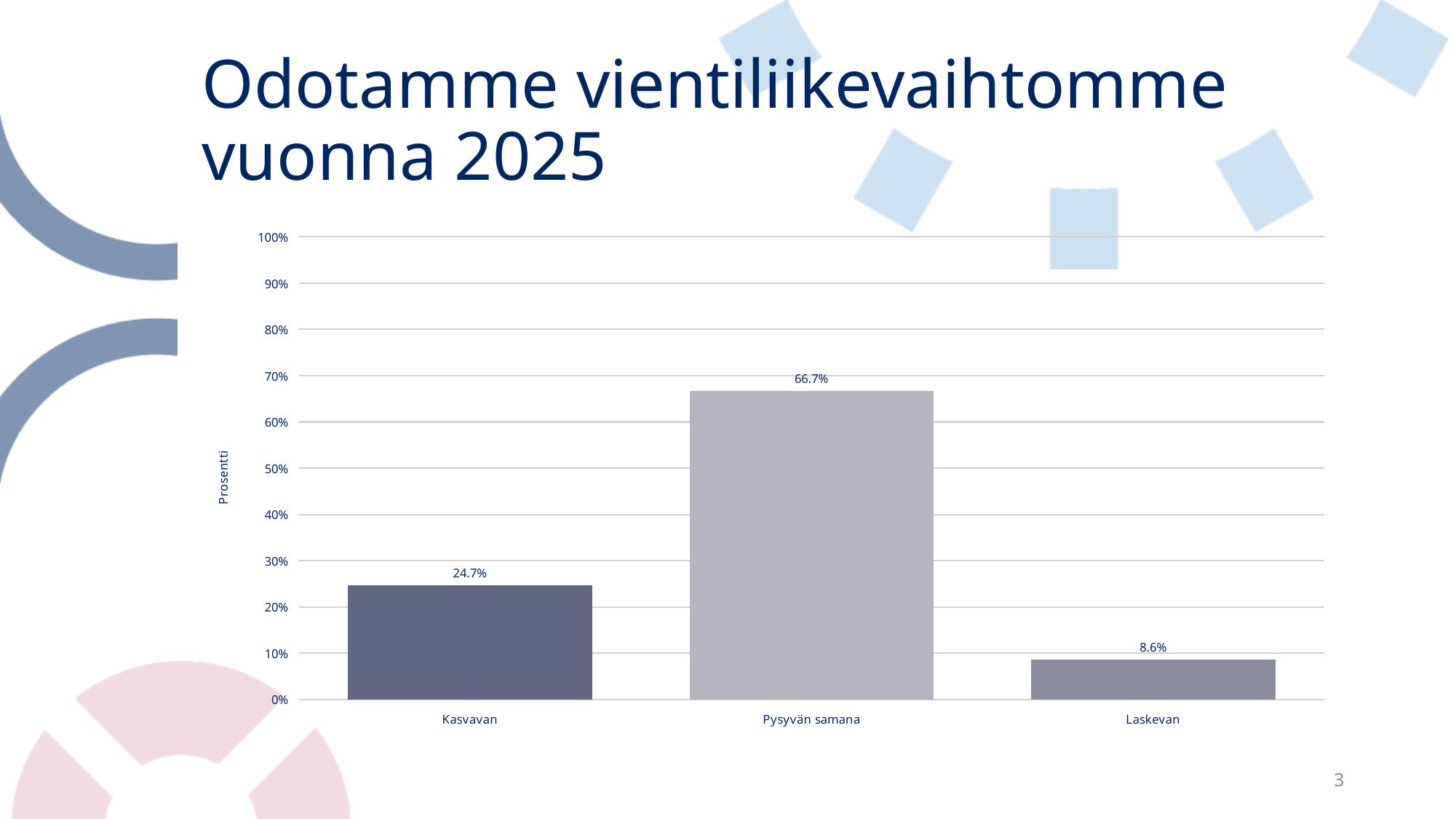
How many categories are shown on the x axis? 3 Which category has the lowest value? Laskevan What kind of chart is shown on the slide? bar chart Is the value for Pysyvän samana greater or less than 60%? greater Which is larger, the value for Kasvavan or the value for Laskevan? Kasvavan What is the value for Kasvavan? 24.7% What is the difference between the values for Pysyvän samana and Kasvavan? 42.0% What is the value for Laskevan? 8.6% What is the value for Pysyvän samana? 66.7% What is the label of the vertical axis? Prosentti What is the difference between the values for Kasvavan and Laskevan? 16.1% Which category has the highest value? Pysyvän samana